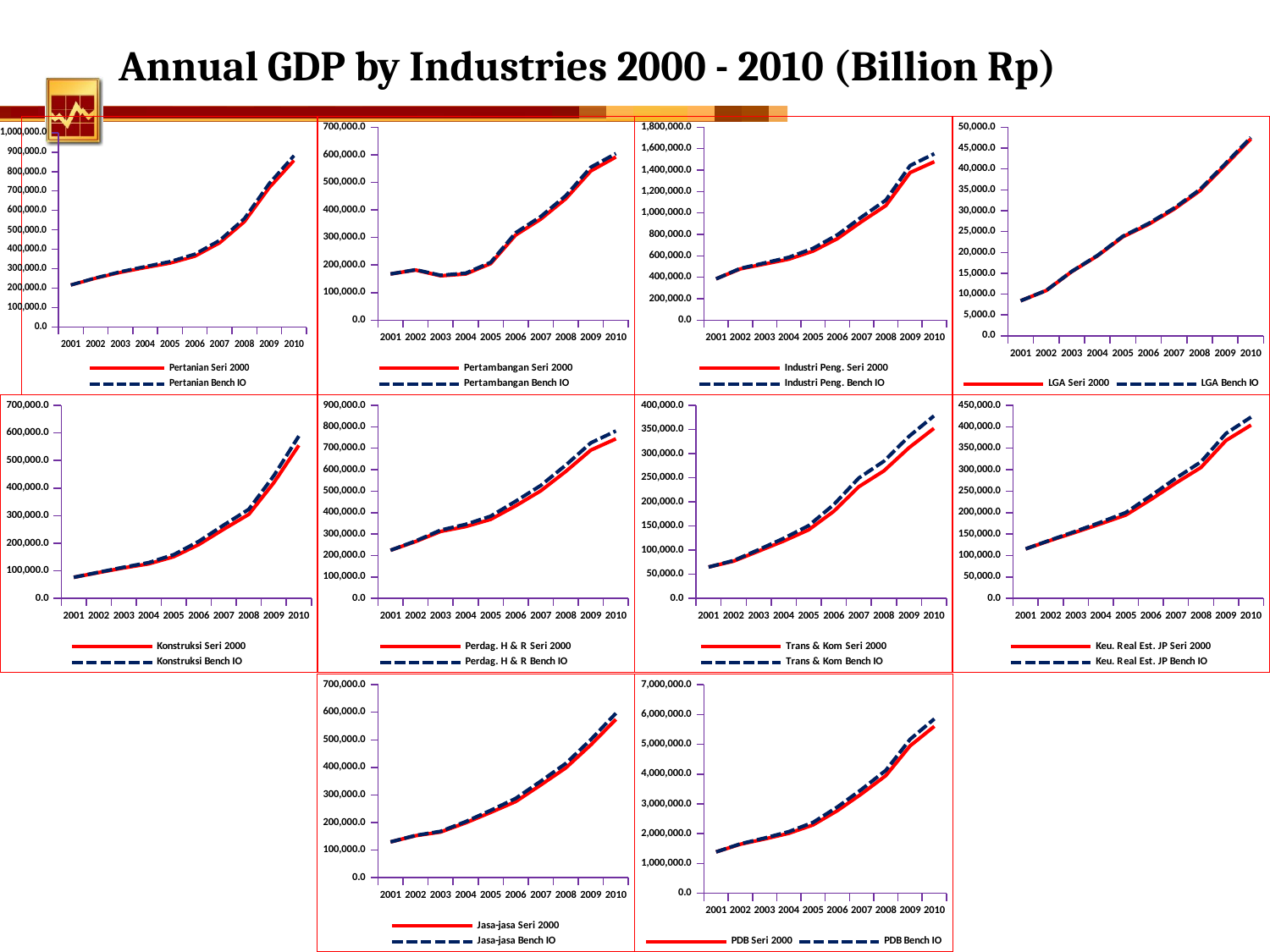
What kind of chart is the Pertanian chart (top left)? line chart In the LGA chart, is the value for LGA Seri 2000 in 2001 greater or less than 10,000.0? less In the Konstruksi chart, is the value for Konstruksi Seri 2000 in 2001 greater or less than 100,000.0? less How many series does the legend of the Pertanian chart list? 2 How many charts are on the slide? 10 In the Pertambangan chart, which series is drawn with a dashed line? Pertambangan Bench IO In the Pertanian chart, is the value for Pertanian Seri 2000 in 2010 greater or less than 800,000.0? greater How many years are shown on the x axis of the Konstruksi chart? 10 In the Konstruksi chart, do the values rise or fall from 2001 to 2010? rise